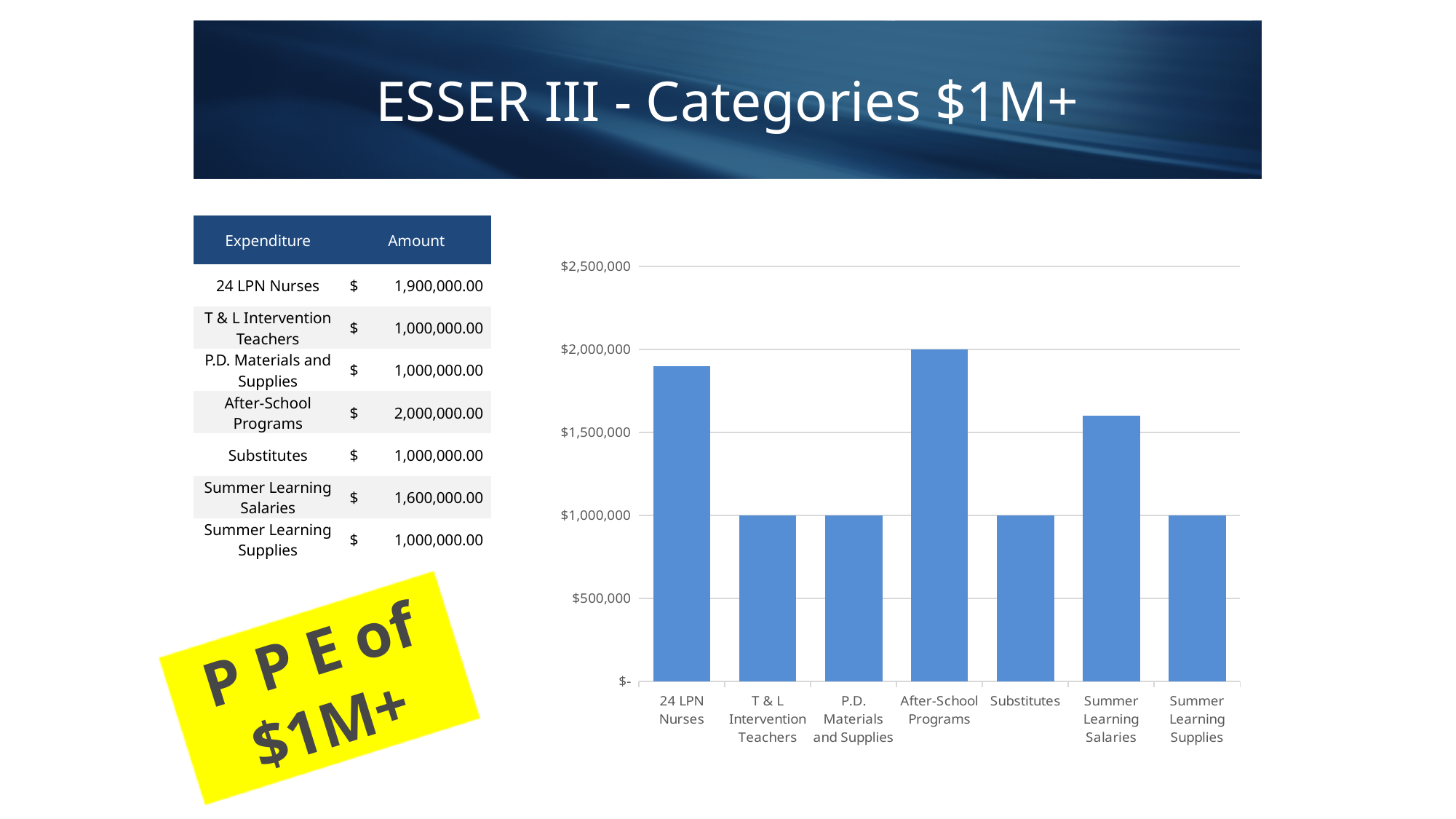
Is the value for Summer Learning Salaries greater or less than $1,500,000? greater What is the amount for 24 LPN Nurses? $1,900,000.00 What is the amount for Summer Learning Salaries? $1,600,000.00 Which category has the highest value in the bar chart? After-School Programs What is the amount for Substitutes? $1,000,000.00 What is the title of the slide containing the bar chart? ESSER III - Categories $1M+ What is the amount for After-School Programs? $2,000,000.00 What is the difference between the amounts for 24 LPN Nurses and Substitutes? $900,000.00 Which is larger, the value for 24 LPN Nurses or the value for Summer Learning Salaries? 24 LPN Nurses How many categories are plotted in the bar chart? 7 What is the difference between the amounts for After-School Programs and Summer Learning Salaries? $400,000.00 What type of chart is shown on the slide? bar chart